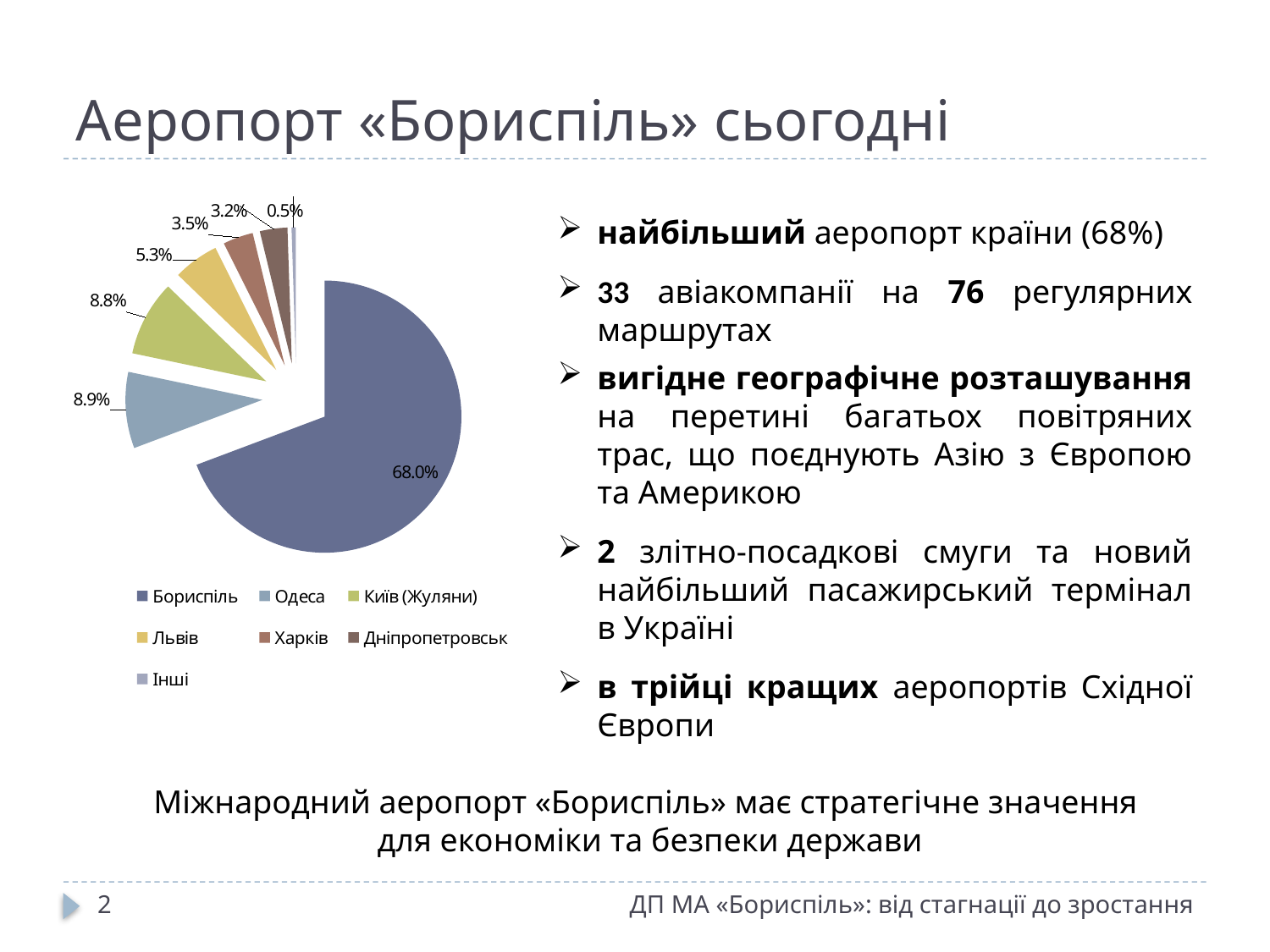
What is the value shown for Інші in the pie chart? 0.5% What share of the pie does Бориспіль have? 68.0% Which category has the largest slice of the pie? Бориспіль Which category has the smallest slice of the pie? Інші What is the value shown for Одеса in the pie chart? 8.9% What is the difference between the shares of Київ (Жуляни) and Дніпропетровськ? 5.6% What is the difference between the shares of Бориспіль and Одеса? 59.1% Which legend entry is listed first in the pie chart's legend? Бориспіль Which is larger, the slice for Львів or the slice for Харків? Львів What type of chart is shown on the slide? pie chart How many categories does the pie chart have? 7 What is the value shown for Львів in the pie chart? 5.3%